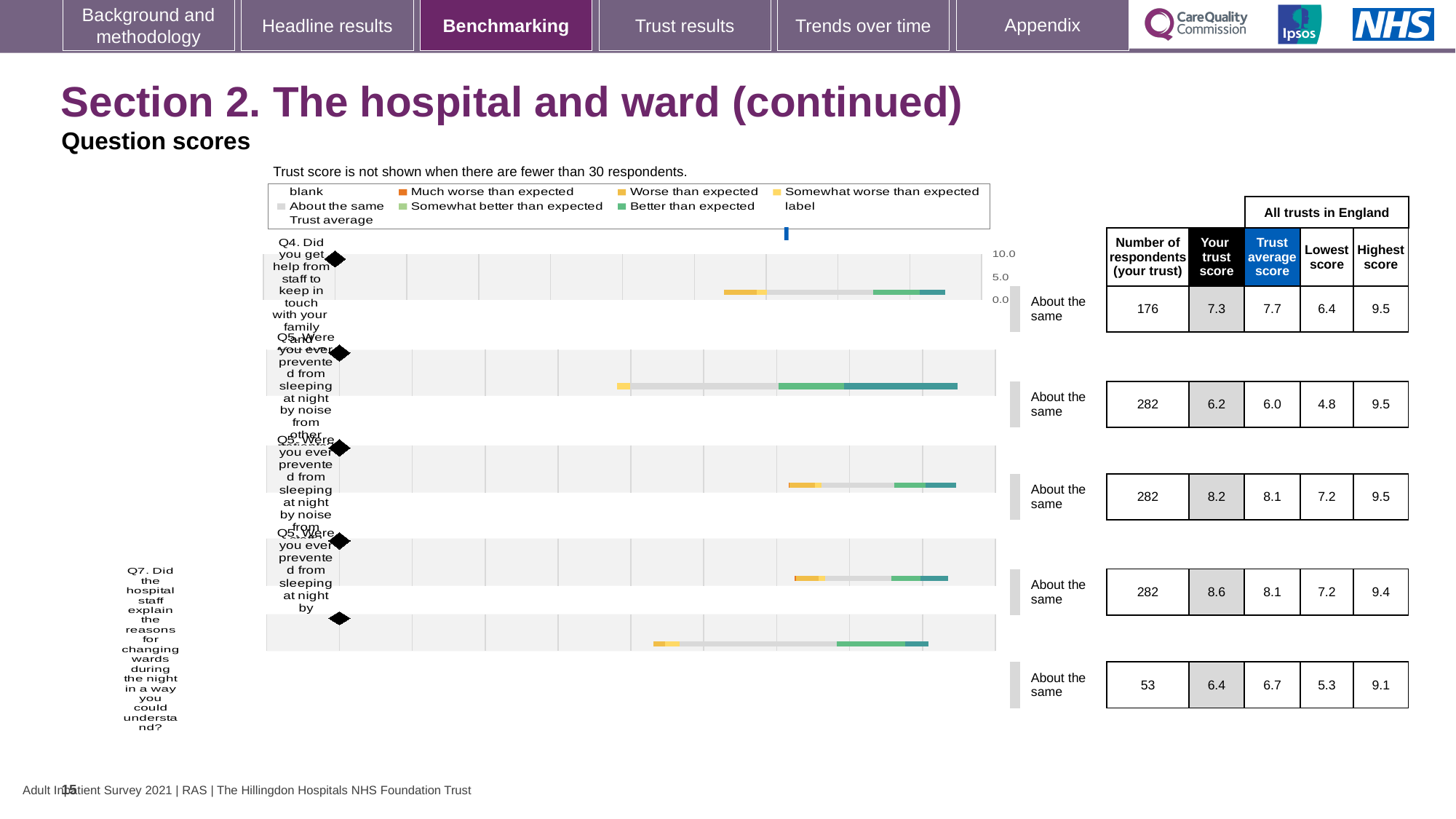
What is the difference between the trust average score and the trust score for Q4? 0.4 What is the highest score across all trusts in England for Q7 (Did the hospital staff explain the reasons for changing wards during the night)? 9.1 Which legend entry is shown in dark orange? Much worse than expected What is the trust score for Q7 (Did the hospital staff explain the reasons for changing wards during the night in a way you could understand)? 6.4 What is the difference between the highest score and the lowest score for Q7? 3.8 What is the number of respondents for Q7 (Did the hospital staff explain the reasons for changing wards during the night in a way you could understand)? 53 What is the number of respondents for Q4 (Did you get help from staff to keep in touch with your family and friends)? 176 How many question bars are plotted in the chart? 5 What is the trust average score for Q4 (Did you get help from staff to keep in touch with your family and friends)? 7.7 What kind of chart is shown on the slide? bar chart What is the trust score for Q4 (Did you get help from staff to keep in touch with your family and friends)? 7.3 Which is larger for Q4: the trust score or the trust average score? trust average score